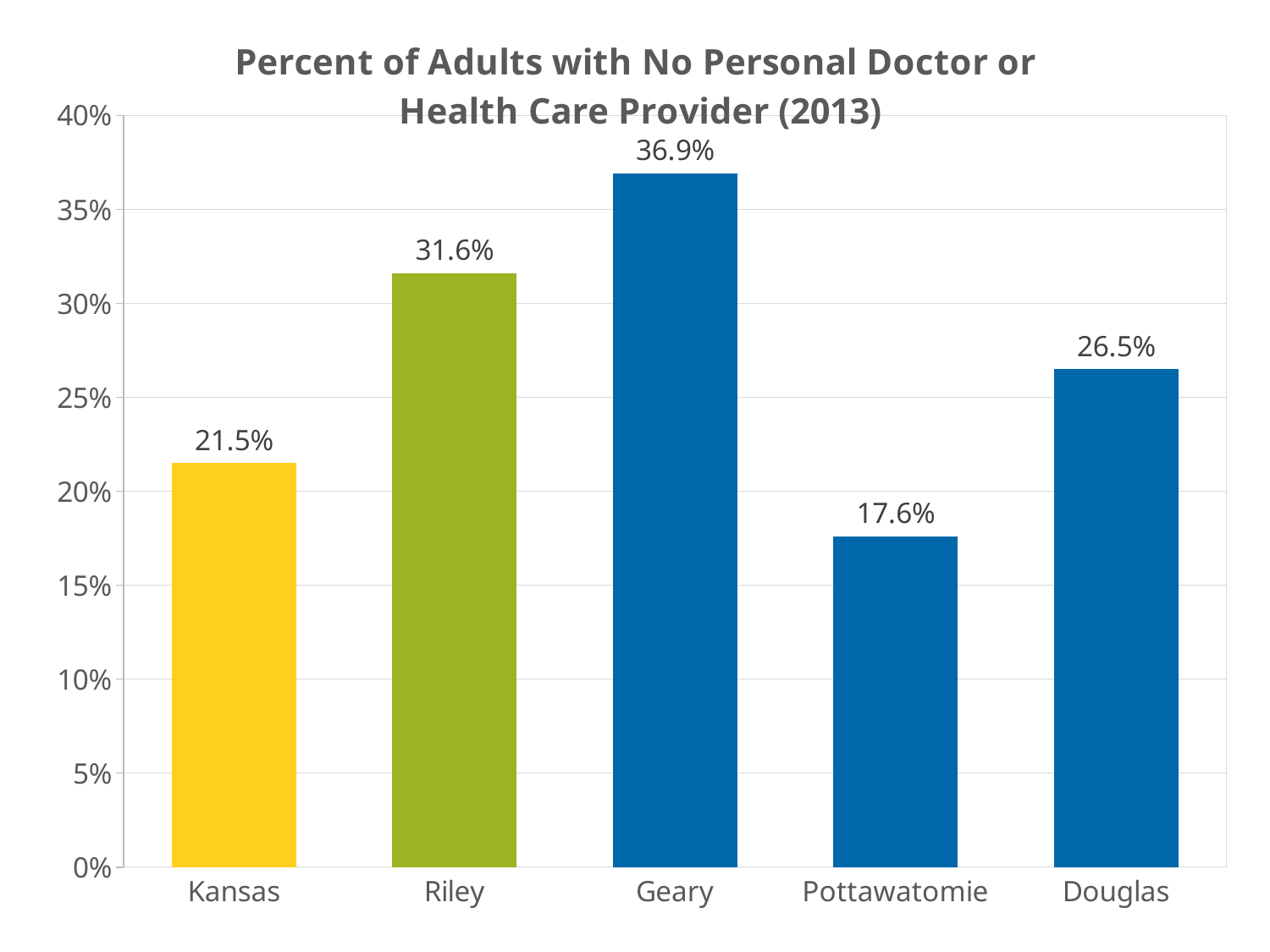
Is the value for Geary greater or less than 35%? greater What is the difference between the values for Douglas and Kansas? 5.0% What is the value for Riley? 31.6% Which category has the highest value? Geary What is the value for Pottawatomie? 17.6% What is the difference between the values for Geary and Riley? 5.3% What is the value for Kansas? 21.5% What kind of chart is this? bar chart Which category has the lowest value? Pottawatomie Which is larger, the value for Douglas or the value for Kansas? Douglas What is the title of the chart? Percent of Adults with No Personal Doctor or Health Care Provider (2013) How many categories are shown on the x axis? 5